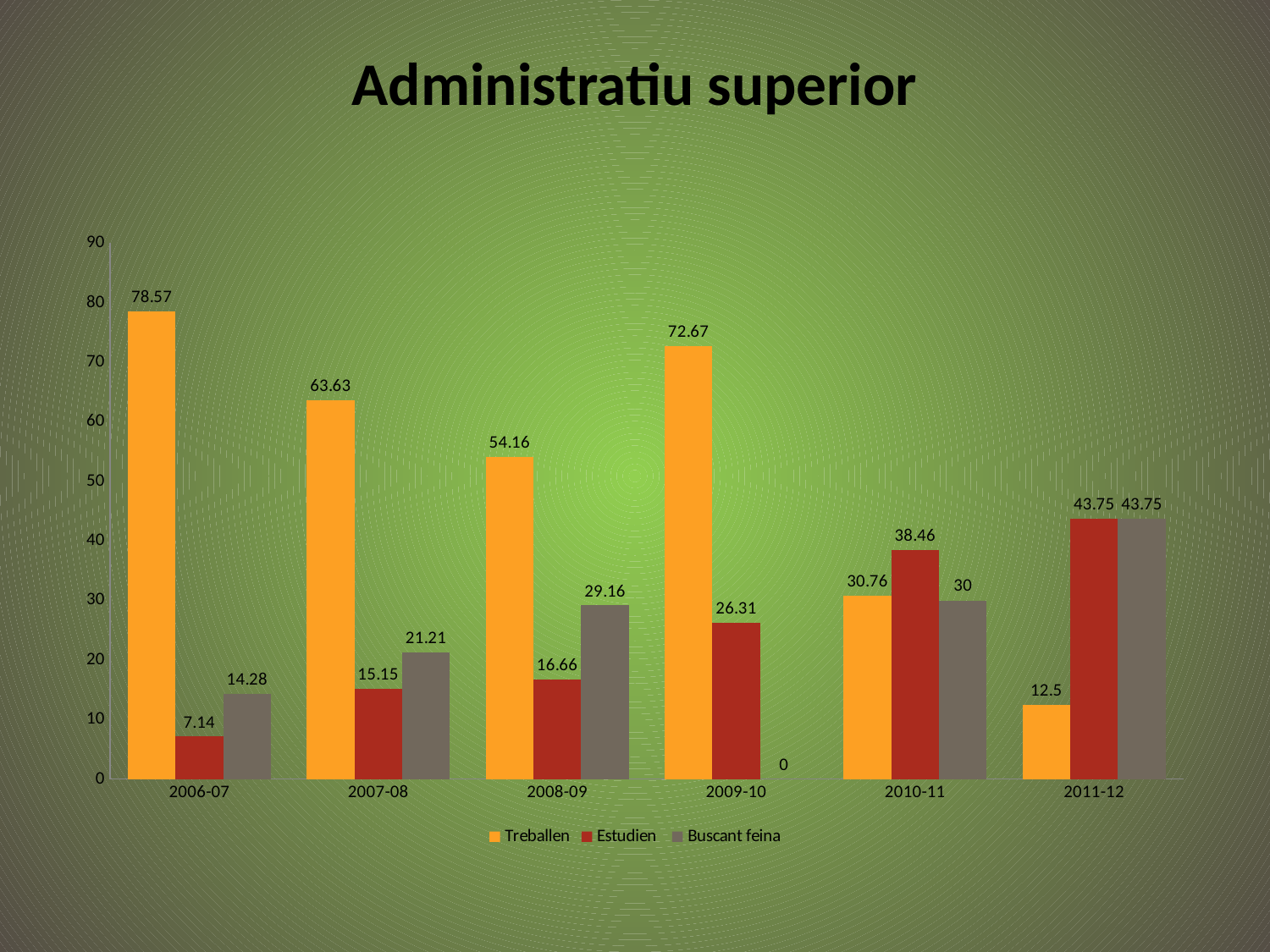
Which is larger in 2011-12, Treballen or Estudien? Estudien What is the value for Buscant feina in 2008-09? 29.16 What is the difference between the Treballen and Estudien values in 2007-08? 48.48 How many series does the legend list? 3 What is the title of the chart? Administratiu superior In which year is the Treballen value lowest? 2011-12 In which year is the Treballen value highest? 2006-07 How many years are shown on the x axis? 6 What kind of chart is shown? Bar chart What is the value for Estudien in 2010-11? 38.46 What is the value for Treballen in 2006-07? 78.57 What is the value for Buscant feina in 2009-10? 0